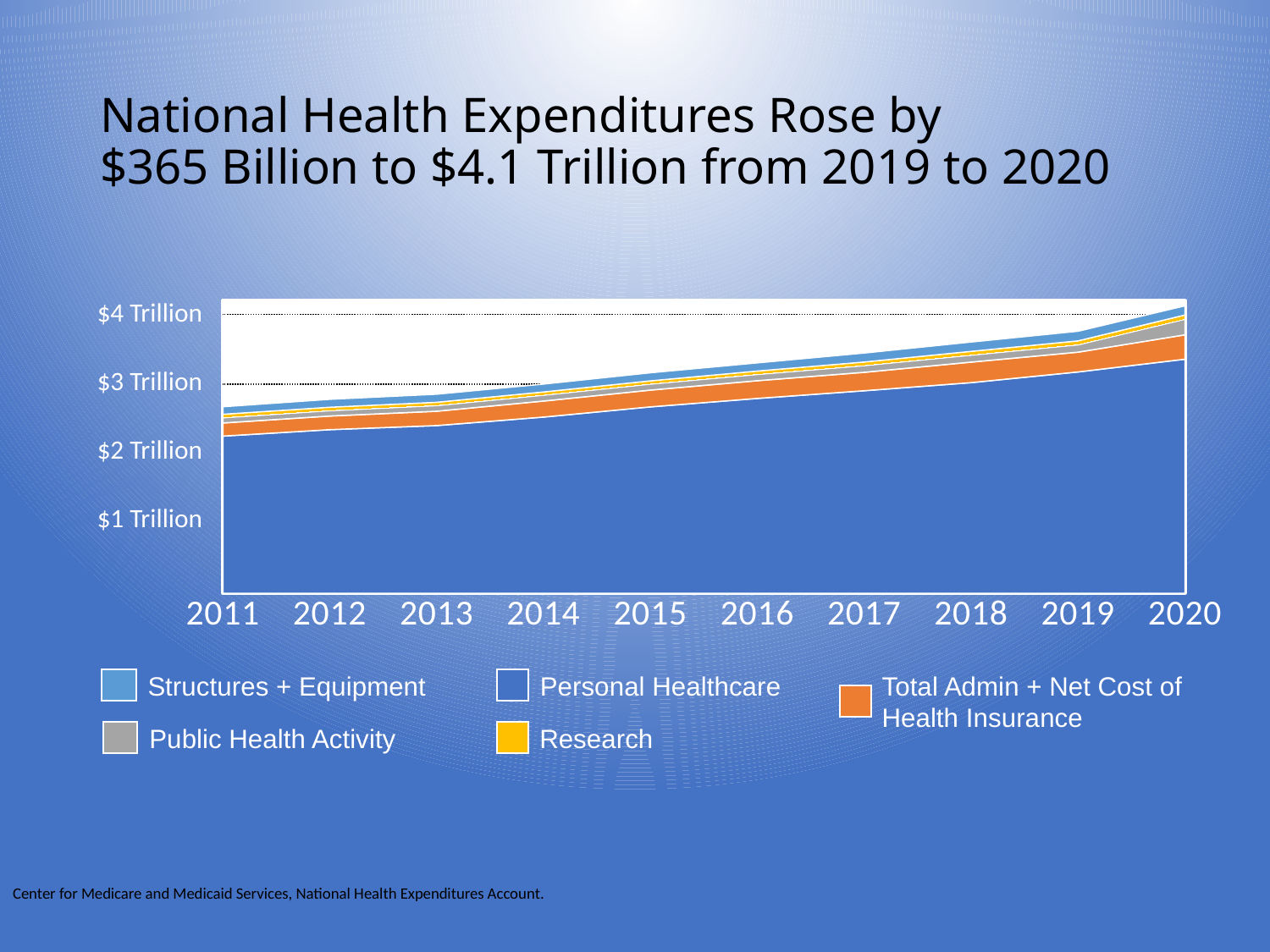
Which series accounts for the largest share of national health expenditures in every year shown? Personal Healthcare Is the value for Personal Healthcare in 2020 greater or less than $3 Trillion? greater Is the total national health expenditure in 2011 greater or less than $3 Trillion? less How many series does the chart's legend list? 5 Is the value for Personal Healthcare in 2011 greater or less than $2 Trillion? greater Which series is shown in yellow in the chart's legend? Research What kind of chart is shown on the slide? Stacked area chart According to the slide title, by how much did national health expenditures rise from 2019 to 2020? $365 Billion How many years are shown along the x axis of the chart? 10 Do total national health expenditures rise or fall from 2011 to 2020? Rise